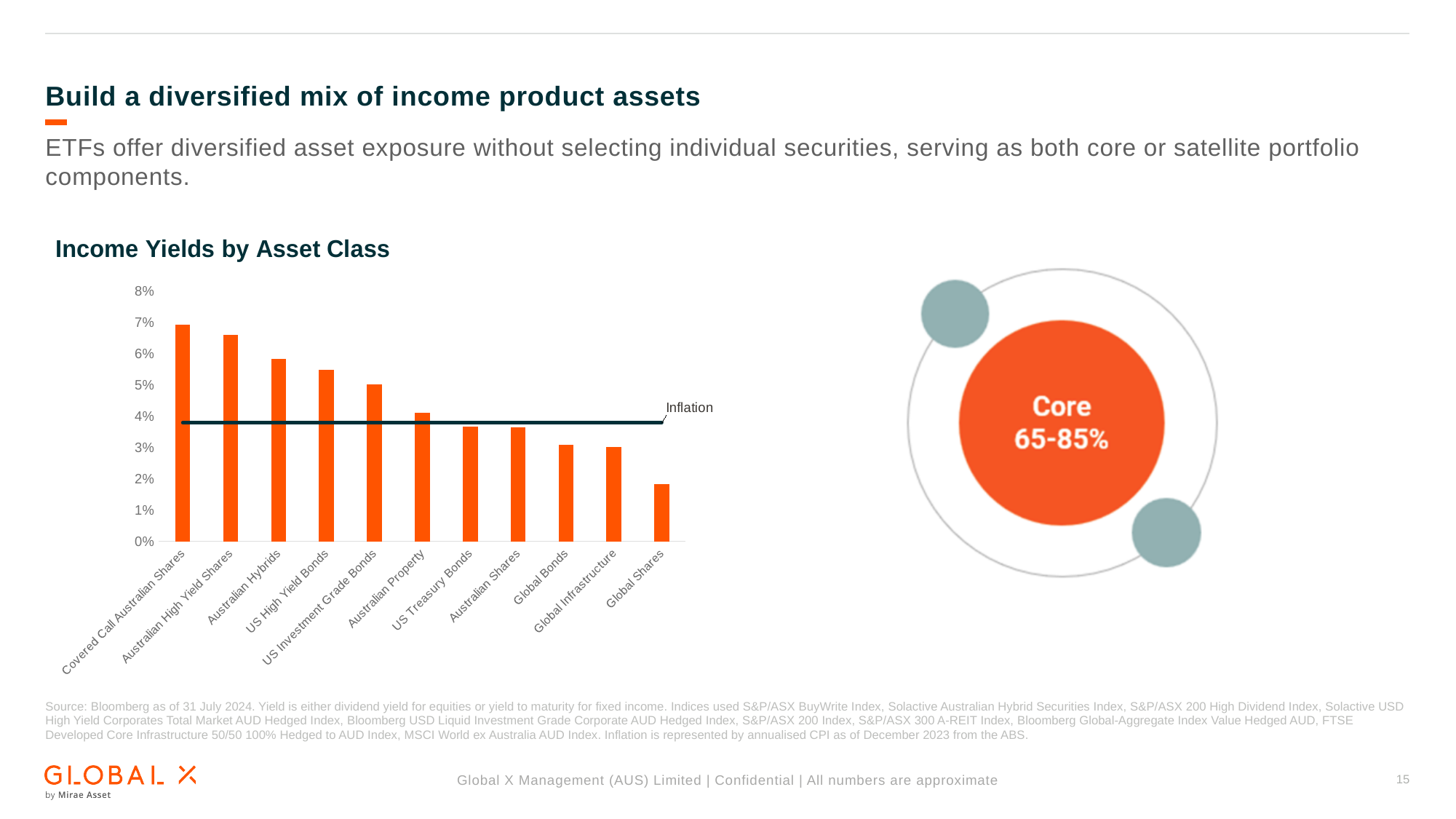
What does the horizontal line drawn across the bar chart represent? Inflation Is the income yield for Covered Call Australian Shares greater or less than 6%? greater Is the income yield for US High Yield Bonds greater or less than 5%? greater Which asset class has the highest income yield in the chart? Covered Call Australian Shares Which has a higher income yield, Australian High Yield Shares or Australian Property? Australian High Yield Shares What kind of chart is used to show Income Yields by Asset Class? Bar chart How many asset classes are shown in the Income Yields by Asset Class chart? 11 Is the income yield for Global Bonds greater or less than 4%? less Which has a higher income yield, Australian Hybrids or Global Infrastructure? Australian Hybrids Which asset class has the lowest income yield in the chart? Global Shares Do the income yields rise or fall moving from left to right across the asset classes? Fall